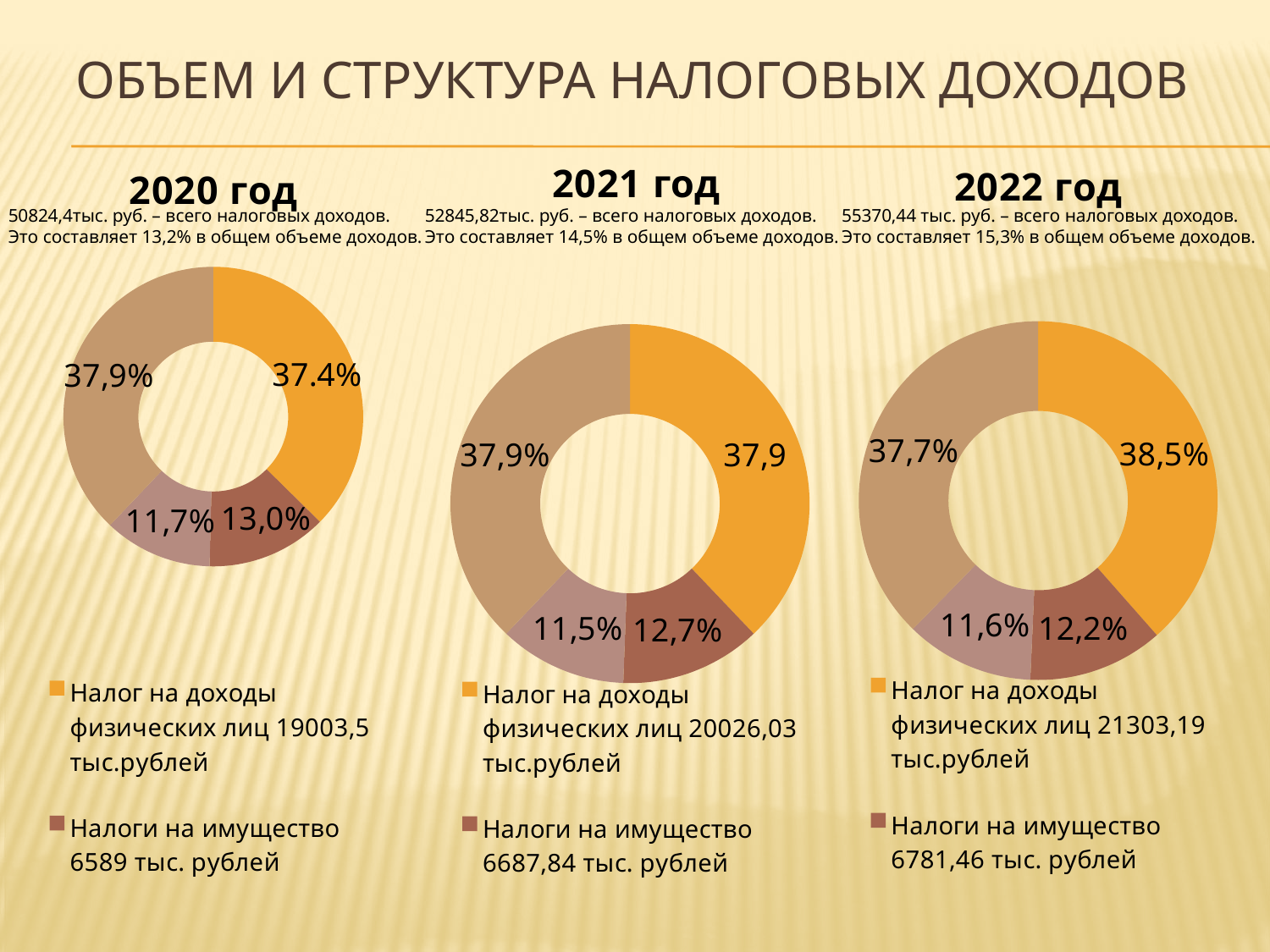
According to the legend of the 2020 год chart, what amount is given for Налог на доходы физических лиц? 19003,5 тыс.рублей In the 2022 год chart, what share is shown for Налог на доходы физических лиц (the orange slice)? 38,5% In the 2022 год chart, what share is shown for Налоги на имущество (the brown slice)? 12,2% In the 2020 год chart, what share is shown for Налог на доходы физических лиц (the orange slice)? 37.4% In the 2022 год chart, what is the difference between the Налог на доходы физических лиц share and the Налоги на имущество share? 26,3% In the 2021 год chart, what share is shown for Налоги на имущество (the brown slice)? 12,7% In the 2022 год chart, which slice is the largest? Налог на доходы физических лиц (38,5%) How many slices does the 2021 год chart have? 4 In the 2020 год chart, what is the smallest slice value? 11,7% In the 2021 год chart, what is the smallest slice value? 11,5% What type of chart is used for each year on the slide? Doughnut (pie) chart Which is larger: the Налоги на имущество share in the 2020 год chart or in the 2022 год chart? 2020 год (13,0%)